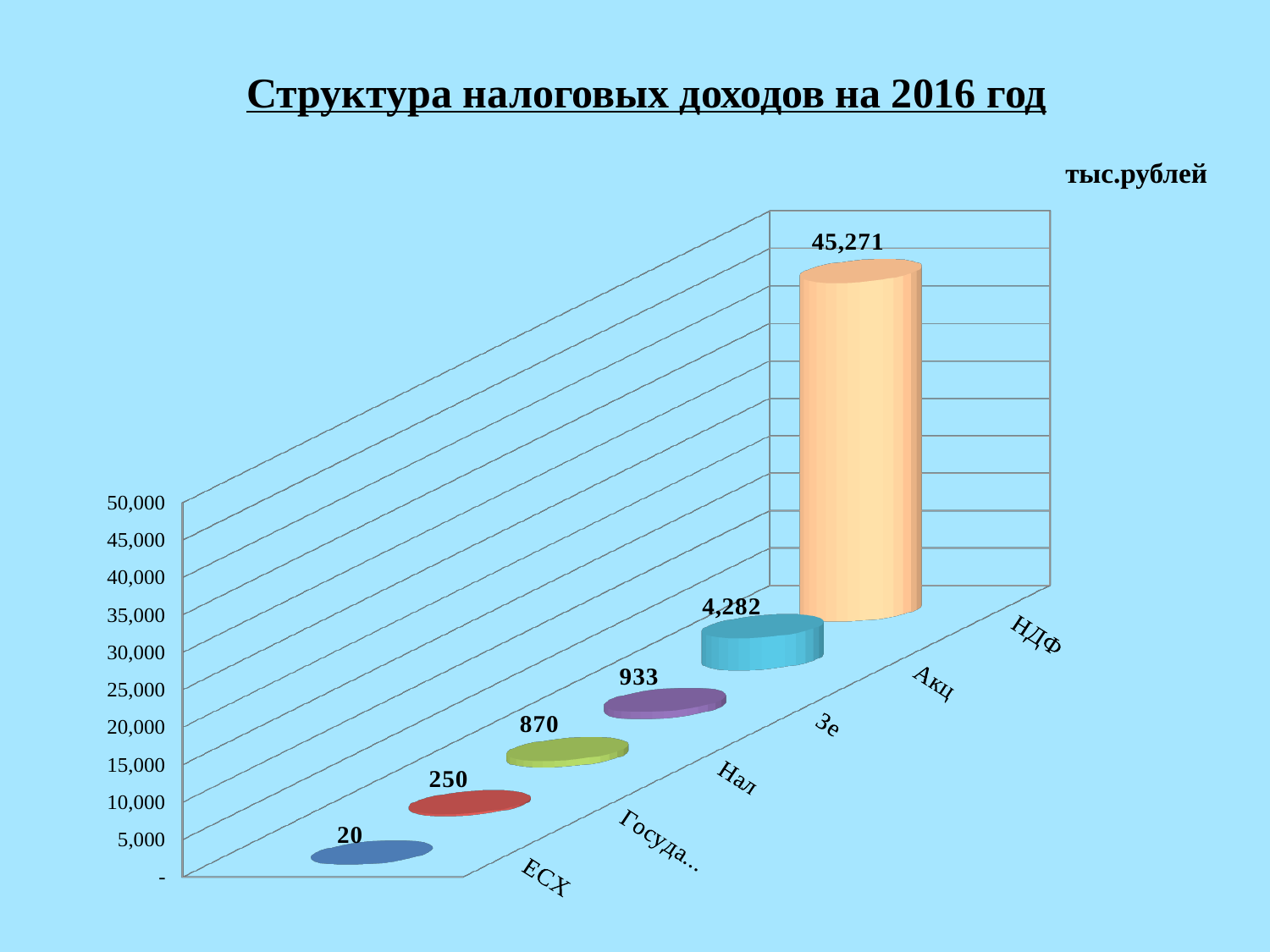
What unit is stated for the values on the chart? тыс.рублей Which category has the lowest value? ЕСХ What is the difference between the values for Зе and Нал? 63 Which is larger, the value for Акц or the value for Нал? Акц What is the value for НДФ? 45,271 What is the value for Зе? 933 What kind of chart is shown on the slide? Bar chart What is the value for ЕСХ? 20 Which category has the highest value? НДФ What is the value for Акц? 4,282 How many categories are shown on the chart? 6 What is the difference between the values for НДФ and Акц? 40,989